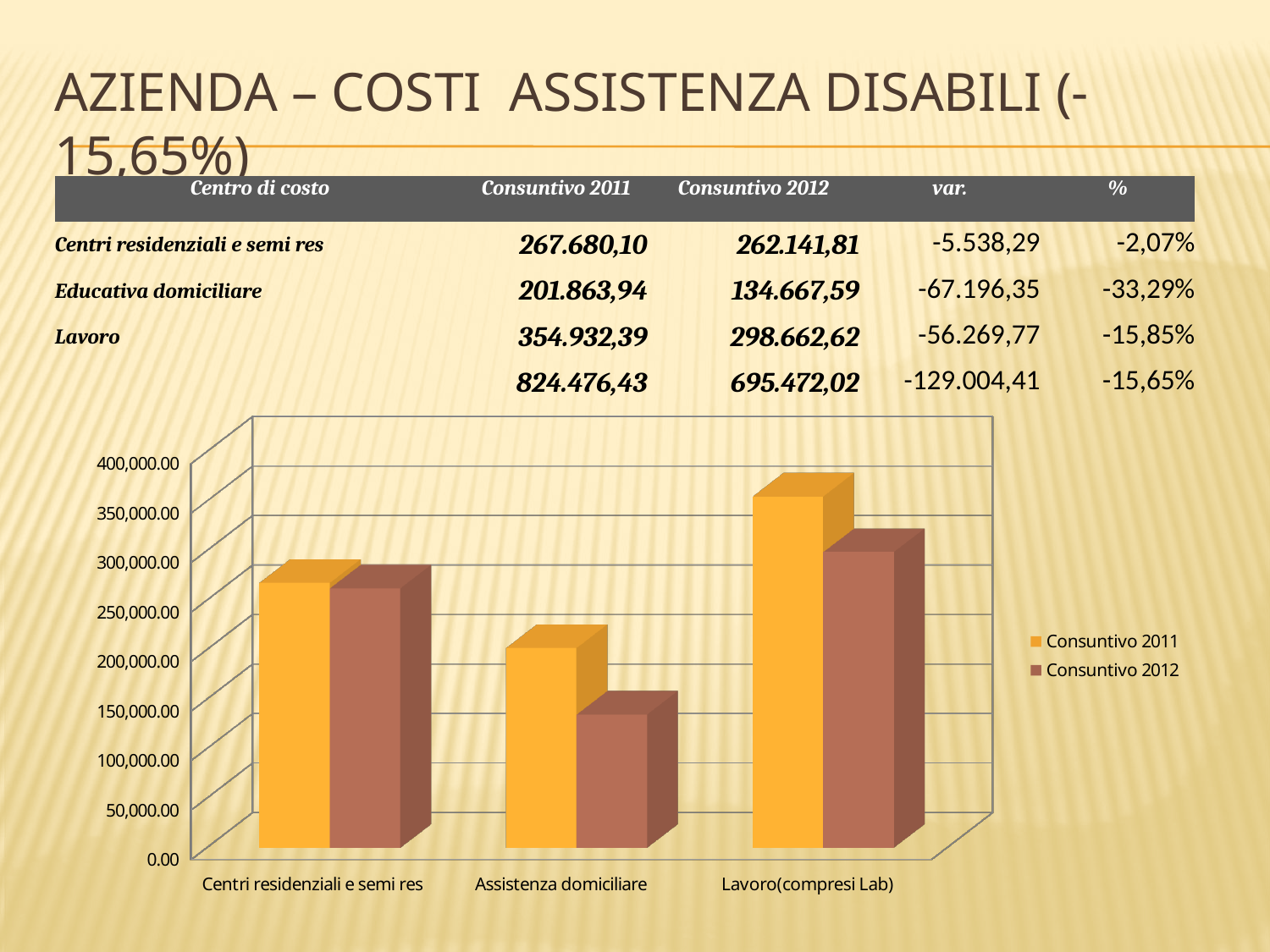
For Lavoro(compresi Lab), which is larger: the Consuntivo 2011 bar or the Consuntivo 2012 bar? Consuntivo 2011 Is the Consuntivo 2011 value for Lavoro(compresi Lab) greater or less than 300,000.00? greater How many series does the chart legend list? 2 Is the Consuntivo 2012 value for Lavoro(compresi Lab) greater or less than 350,000.00? less Which series is shown in orange in the chart? Consuntivo 2011 Is the Consuntivo 2011 value for Centri residenziali e semi res greater or less than 250,000.00? greater Which category has the highest Consuntivo 2011 bar in the chart? Lavoro(compresi Lab) Which category has the lowest Consuntivo 2011 bar in the chart? Assistenza domiciliare Which category has the lowest Consuntivo 2012 bar in the chart? Assistenza domiciliare How many categories are shown on the x axis of the chart? 3 What kind of chart is shown on the slide? bar chart